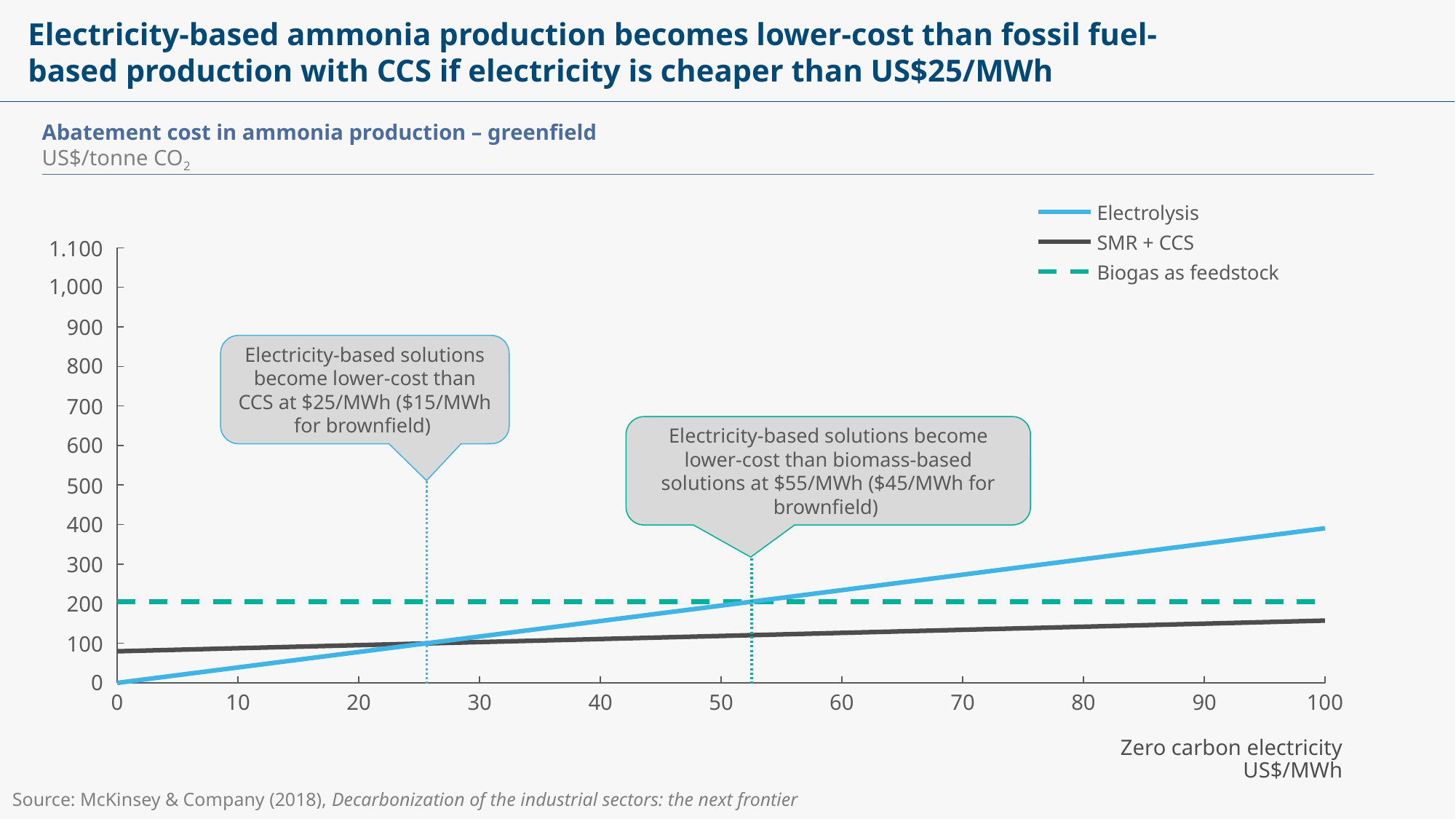
At 0 US$/MWh, which is larger: the Electrolysis value or the SMR + CCS value? SMR + CCS Does the Electrolysis line rise or fall as zero carbon electricity cost increases from 0 to 100 US$/MWh? rise How many series does the legend list? 3 At 100 US$/MWh, which series has the lowest abatement cost? SMR + CCS What is the Electrolysis abatement cost at 0 US$/MWh? 0 Is the SMR + CCS value at 0 US$/MWh greater or less than 200? less What kind of chart is shown on the slide? line chart Is the Biogas as feedstock value greater or less than 300? less What is the title of the chart? Abatement cost in ammonia production – greenfield Is the Electrolysis value at 100 US$/MWh greater or less than 300? greater At 100 US$/MWh, which series has the highest abatement cost? Electrolysis